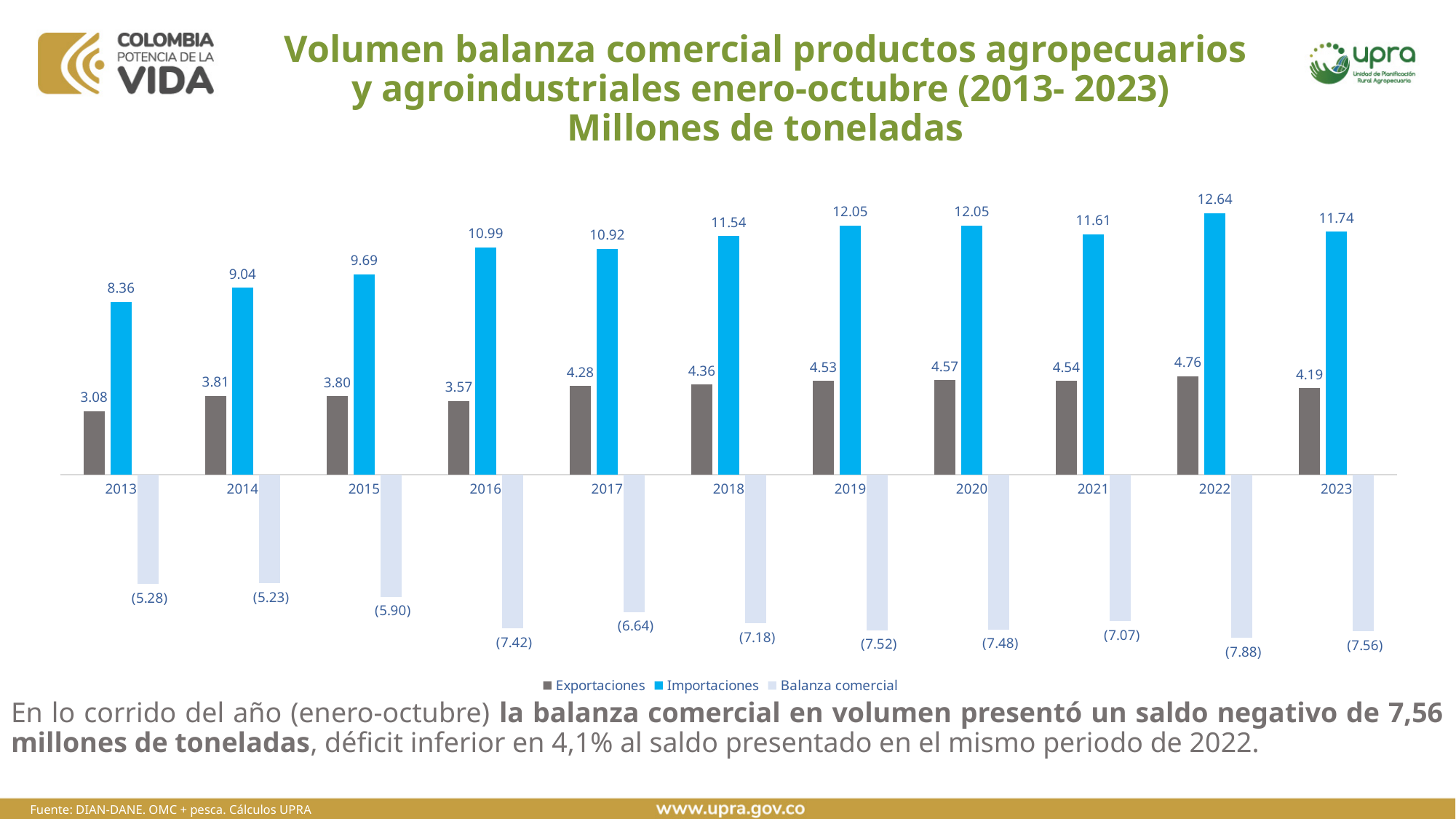
What is the difference between Importaciones and Exportaciones in 2023? 7.55 What is the value of Exportaciones for 2023? 4.19 In which year is the Exportaciones value lowest? 2013 Which series is shown in light blue in the legend? Balanza comercial What is the value of Balanza comercial for 2022? (7.88) In which year is the Importaciones value highest? 2022 How many series does the legend list? 3 How many years are shown on the x axis? 11 What is the value of Importaciones for 2016? 10.99 Which year has the larger Exportaciones value, 2017 or 2018? 2018 What kind of chart is shown on the slide? Bar chart Do the Importaciones values rise or fall from 2013 to 2016? Rise